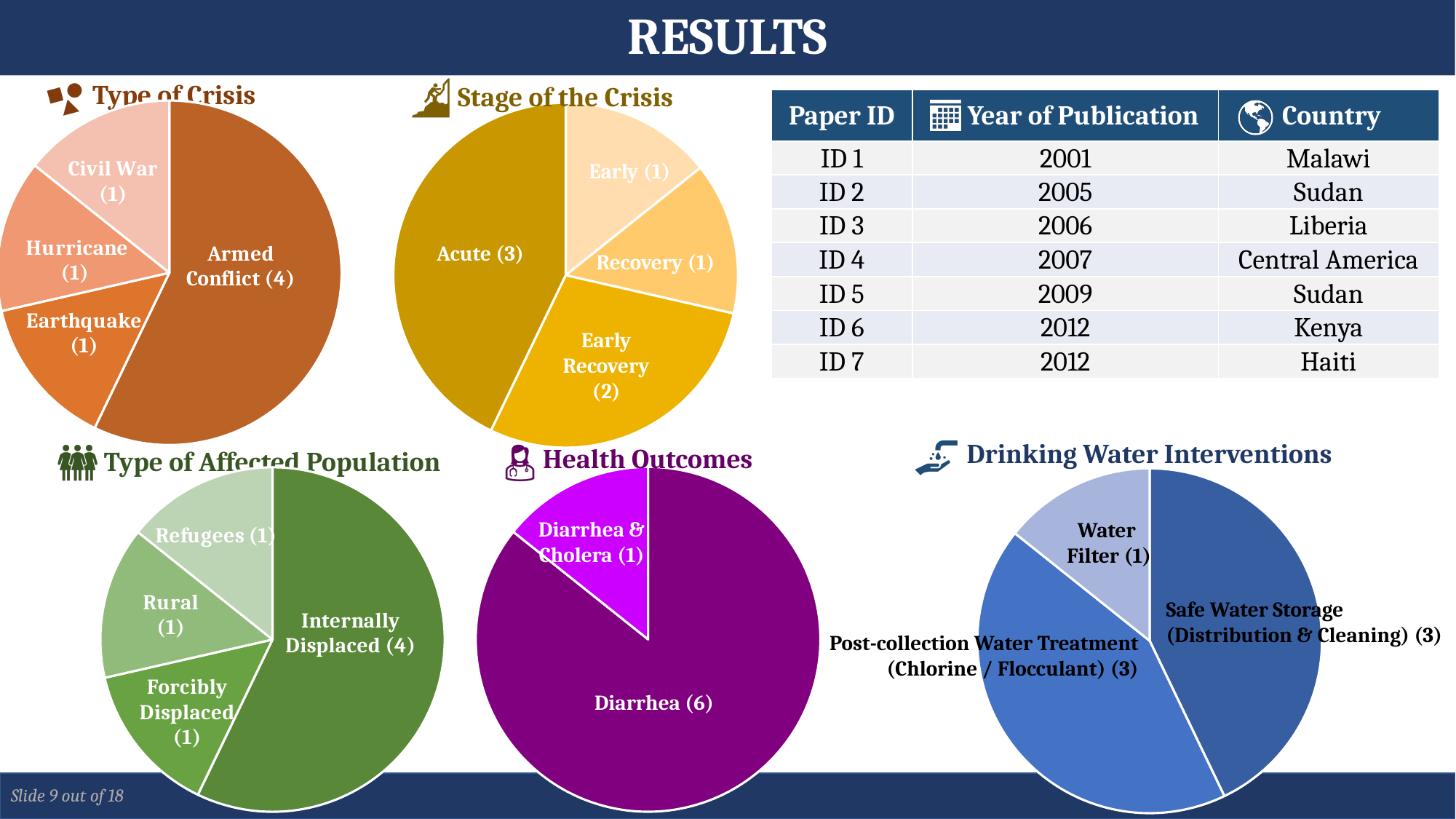
What kind of chart is the Drinking Water Interventions chart? Pie chart In the Health Outcomes chart, what is the value for Diarrhea? 6 In the Type of Affected Population chart, what is the value for Internally Displaced? 4 In the Type of Crisis chart, how many papers are in the Armed Conflict slice? 4 How many slices does the Stage of the Crisis chart have? 4 In the Stage of the Crisis chart, what is the value for Early Recovery? 2 In the Drinking Water Interventions chart, which category has the smallest slice? Water Filter In the Stage of the Crisis chart, what is the difference between the Acute and Early values? 2 In the Type of Crisis chart, which category has the largest slice? Armed Conflict In the Type of Affected Population chart, which is larger, Internally Displaced or Rural? Internally Displaced In the Health Outcomes chart, what is the difference between the Diarrhea and Diarrhea & Cholera values? 5 How many pie charts are shown on the slide? 5